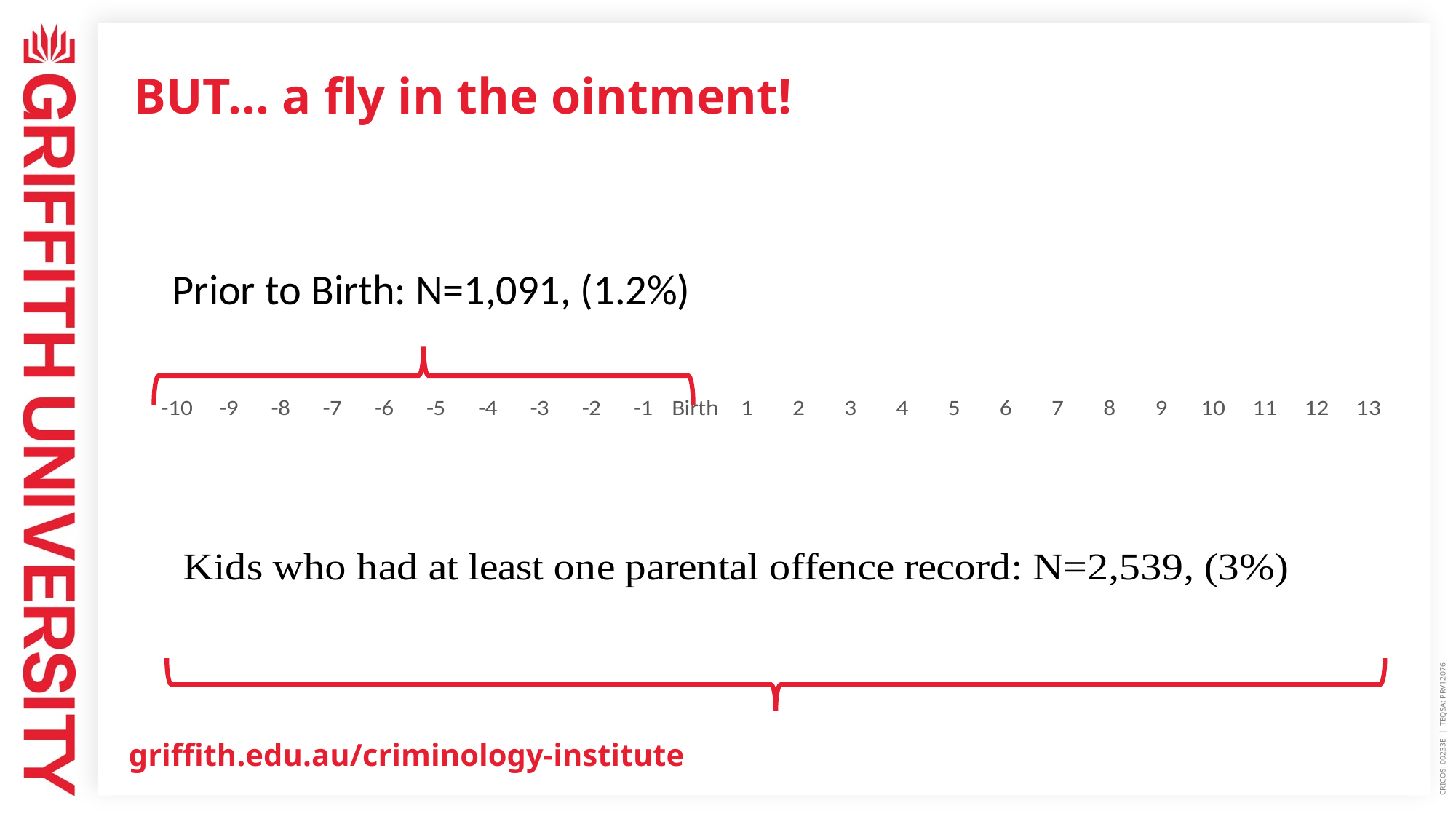
According to the annotation above the axis, what is N for the Prior to Birth period? 1,091 What is N for kids who had at least one parental offence record? 2,539 What is the rightmost label on the chart's x axis? 13 Is the N for Prior to Birth greater or less than 1,000? greater What is the difference between the N for kids with at least one parental offence record and the N for Prior to Birth? 1,448 Which is larger: the N for Prior to Birth or the N for kids who had at least one parental offence record? Kids who had at least one parental offence record What percentage is given for kids who had at least one parental offence record? 3% What percentage is given for the Prior to Birth period? 1.2% How many tick labels are shown along the x axis of the chart? 24 What is the leftmost label on the chart's x axis? -10